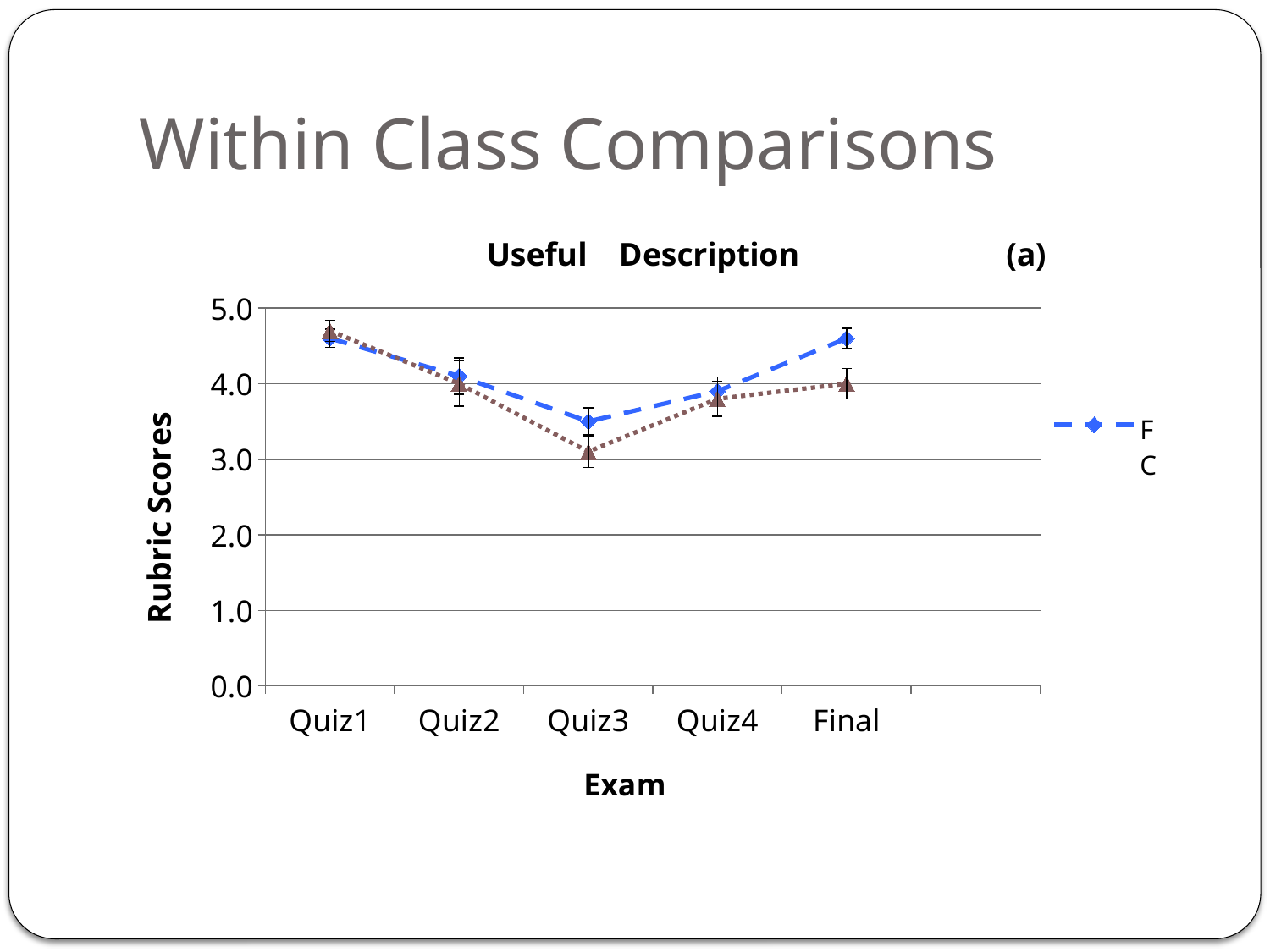
Is the value for series C at Quiz2 greater or less than 3.0? greater What kind of chart is shown on the slide? line chart Do the rubric scores for series F rise or fall from Quiz1 to Quiz3? fall At Final, which series has the higher rubric score, F or C? F At Quiz3, which series has the higher rubric score, F or C? F Is the value for series F at Final greater or less than 4.0? greater How many exams are plotted along the x axis? 5 How many series does the legend list? 2 For which exam does series C reach its lowest rubric score? Quiz3 What is the label of the y axis? Rubric Scores Is the value for series F at Quiz3 greater or less than 4.0? less For which exam does series F reach its lowest rubric score? Quiz3